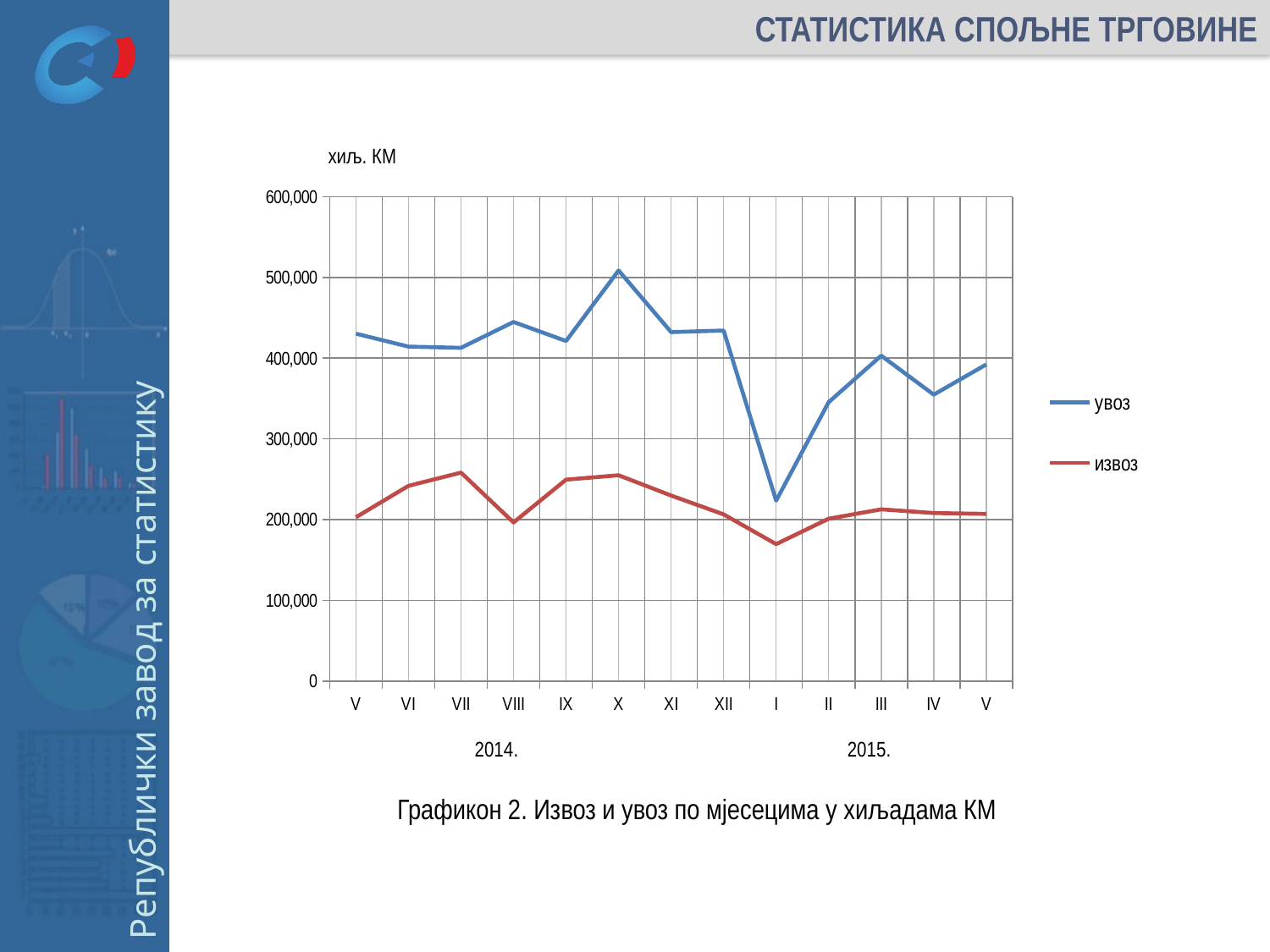
Is the value of увоз in V 2014 greater or less than 400,000? greater How many months are plotted along the x axis? 13 Which series has the larger value in X 2014, увоз or извоз? увоз Is the value of извоз in VII 2014 greater or less than 200,000? greater In which month does the извоз series reach its lowest value? I 2015 What kind of chart is shown on the slide? line chart What unit is shown above the y axis of the chart? хиљ. КМ Is the value of извоз in I 2015 greater or less than 200,000? less In which month does the увоз series reach its highest value? X 2014 In which month does the увоз series reach its lowest value? I 2015 How many series does the legend list? 2